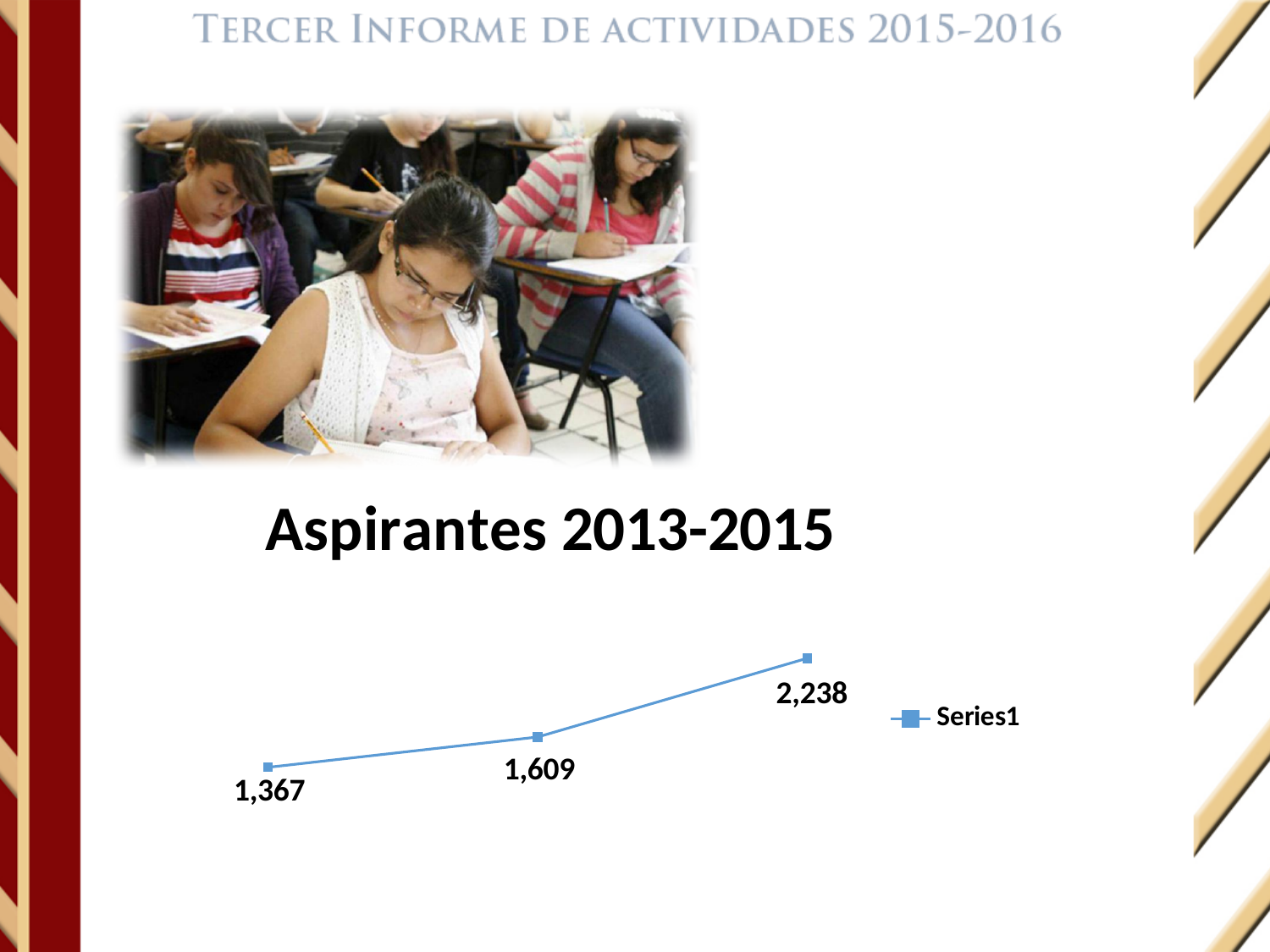
What is the value of the middle data point on the chart? 1,609 What series name does the legend show? Series1 Which is larger, the middle data point or the last data point? the last data point (2,238) What is the value of the last (rightmost) data point on the chart? 2,238 What is the value of the first (leftmost) data point on the chart? 1,367 What is the difference between the middle data point (1,609) and the first data point (1,367)? 242 Do the values rise or fall from left to right along the line? rise What is the lowest value plotted on the chart? 1,367 What kind of chart is shown under the title "Aspirantes 2013-2015"? line chart What is the difference between the last data point (2,238) and the first data point (1,367)? 871 What is the highest value plotted on the chart? 2,238 How many data points are plotted on the line? 3